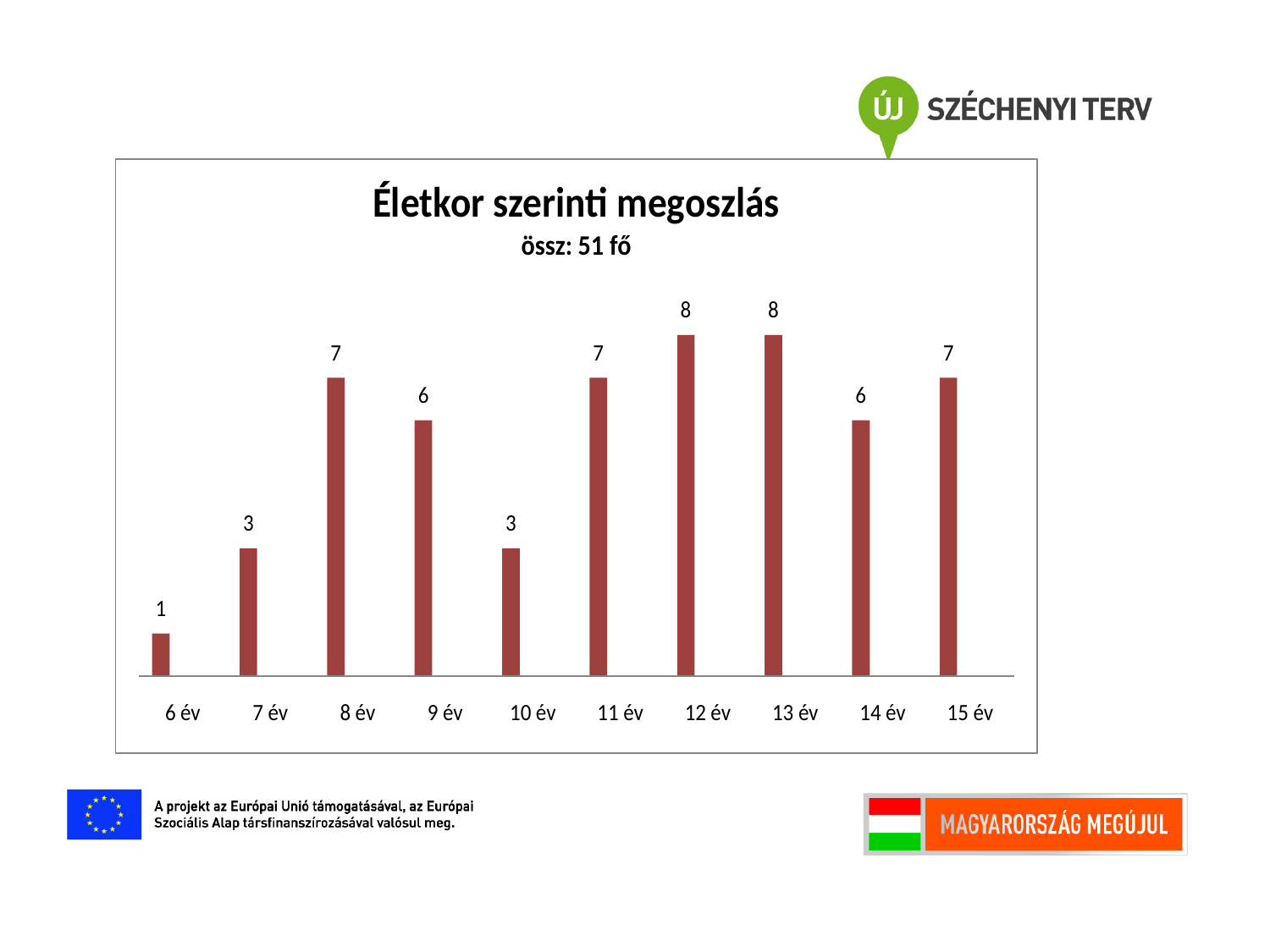
What is the title of the chart? Életkor szerinti megoszlás What is the value for 10 év? 3 What is the value for 14 év? 6 Which category has the lowest value? 6 év Which is larger, the value for 7 év or the value for 14 év? 14 év What is the value for 8 év? 7 What is the difference between the values for 12 év and 7 év? 5 What kind of chart is this? bar chart How many categories are shown on the x axis? 10 What is the difference between the values for 15 év and 6 év? 6 What total is stated in the chart subtitle? össz: 51 fő Which is larger, the value for 9 év or the value for 11 év? 11 év